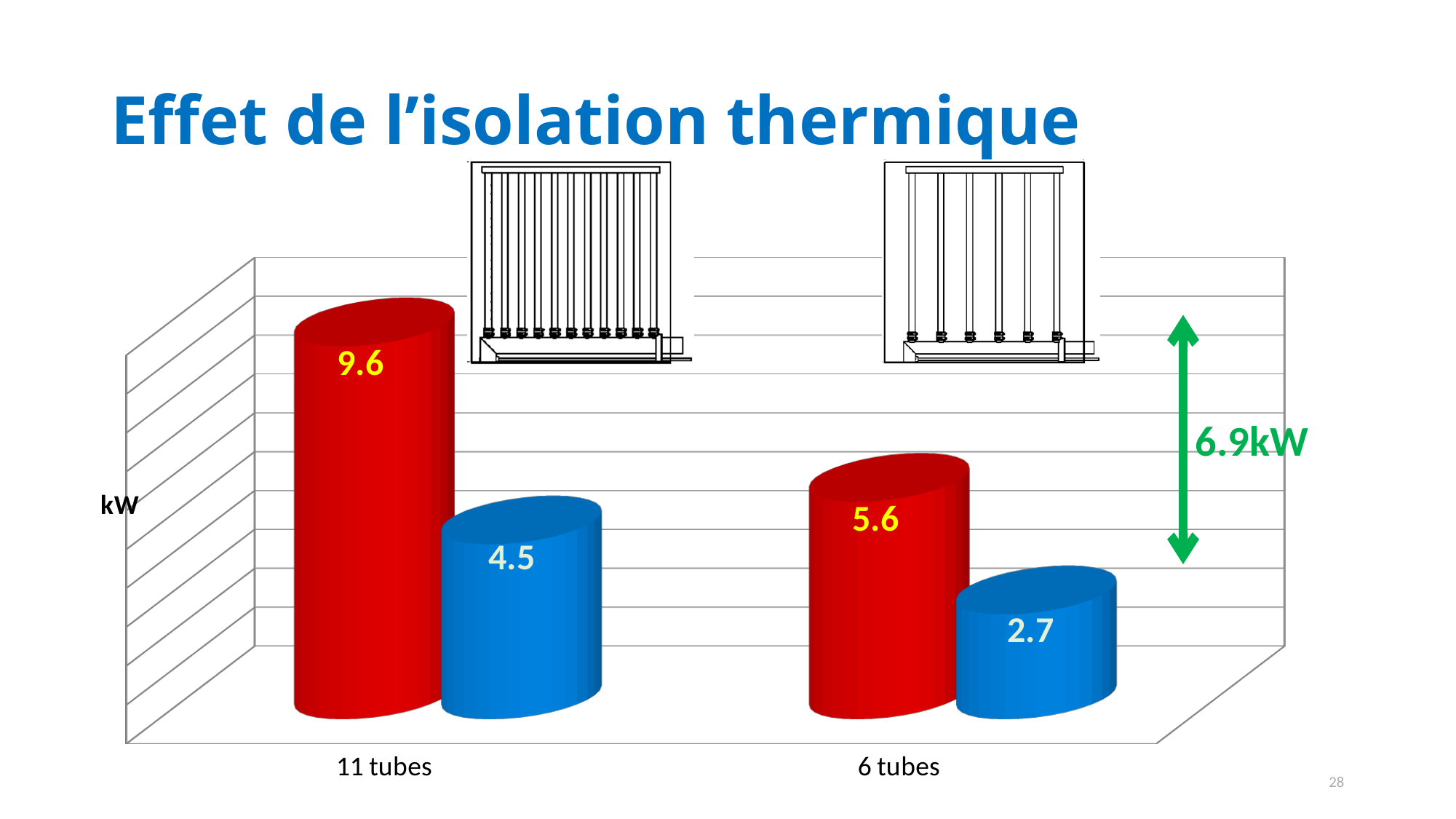
What is the title of the slide containing the chart? Effet de l'isolation thermique What is the value of the red bar for 11 tubes? 9.6 What is the value of the blue bar for 11 tubes? 4.5 How many categories are shown on the x axis? 2 What is the value of the red bar for 6 tubes? 5.6 Which bar has the lowest value on the chart? The blue bar for 6 tubes (2.7) What is the difference between the red bar values for 11 tubes and 6 tubes? 4.0 What is the difference between the red and blue bars for 11 tubes? 5.1 Which bar has the highest value on the chart? The red bar for 11 tubes (9.6) Which is larger, the blue bar for 11 tubes or the red bar for 6 tubes? The red bar for 6 tubes What kind of chart is shown on the slide? Bar chart What is the value of the blue bar for 6 tubes? 2.7